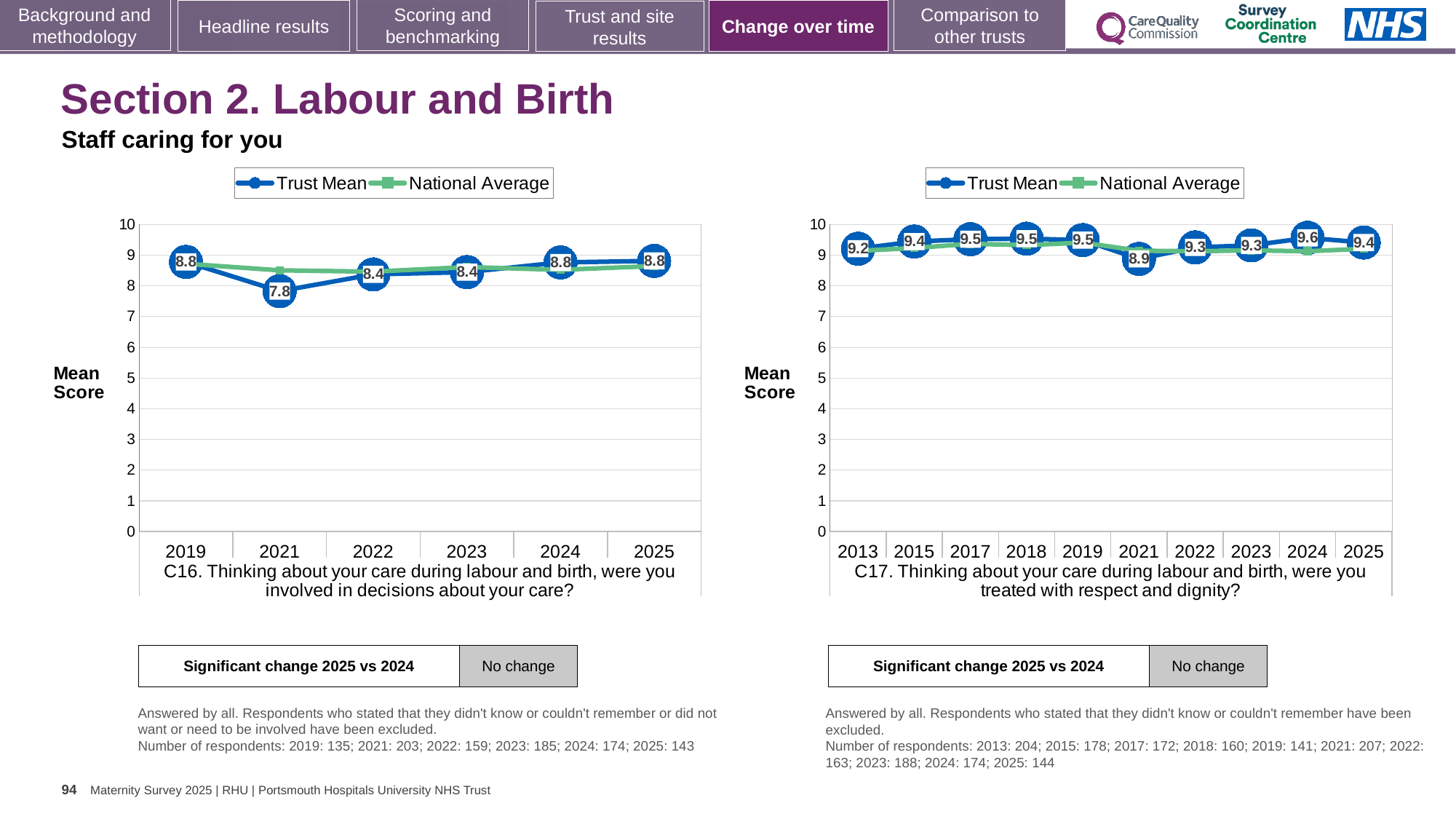
In the C16 chart (left), what is the Trust Mean for 2025? 8.8 What kind of chart is the C16 chart (left)? Line chart In the C16 chart (left), what is the difference between the Trust Mean for 2019 and 2021? 1.0 In the C17 chart (right), what is the Trust Mean for 2024? 9.6 In the C17 chart (right), how many years are shown on the x axis? 10 In the C17 chart (right), is the Trust Mean for 2024 larger or smaller than for 2025? larger How many series does the legend of the C17 chart (right) list? 2 In the C17 chart (right), what is the Trust Mean for 2021? 8.9 In the C16 chart (left), how many years are shown on the x axis? 6 In the C17 chart (right), which year has the highest Trust Mean? 2024 In the C16 chart (left), what is the Trust Mean for 2021? 7.8 In the C16 chart (left), which year has the lowest Trust Mean? 2021